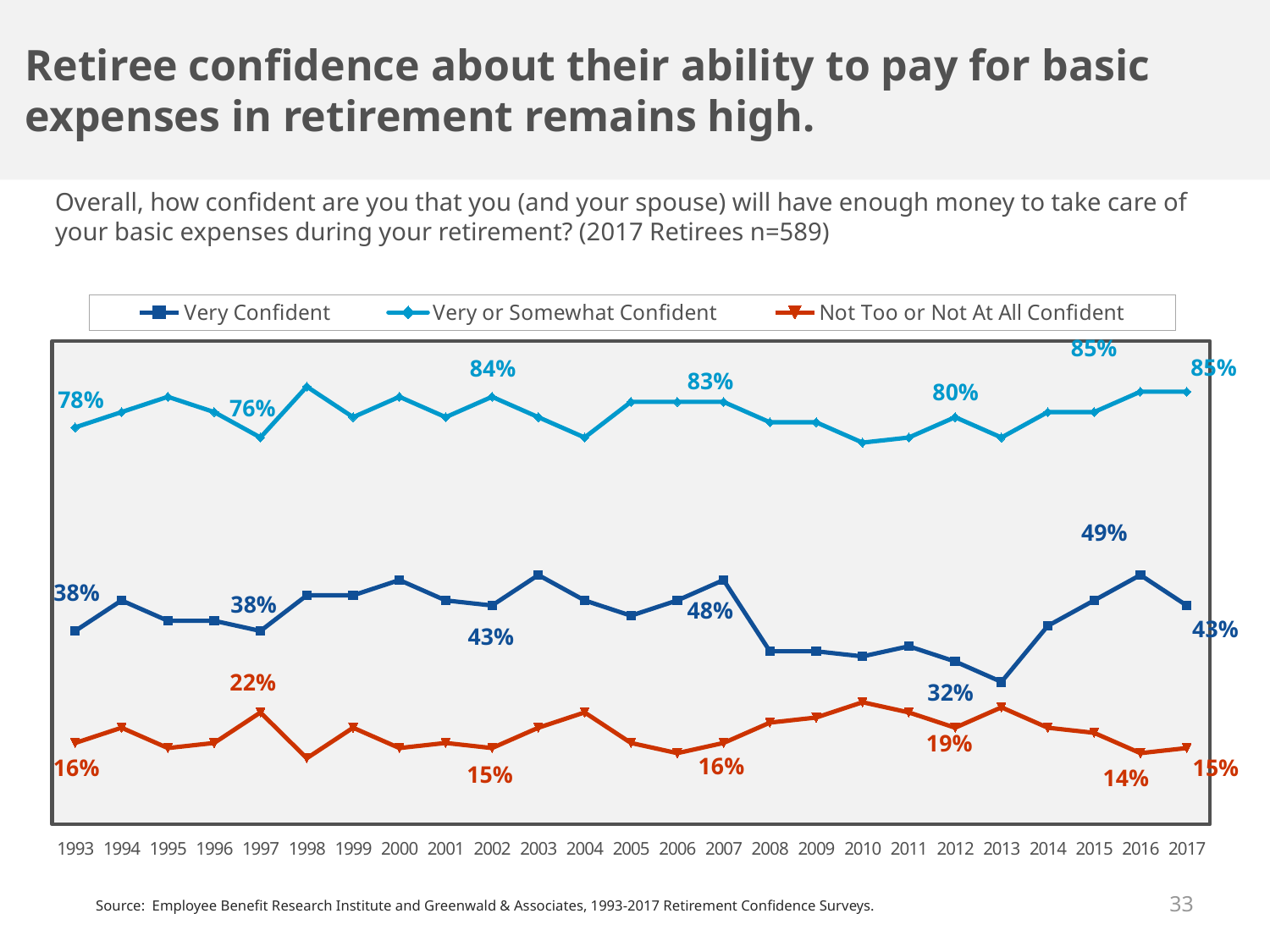
How many series does the legend list? 3 Which year has the higher Very Confident value, 2007 or 2012? 2007 By how many percentage points did Very or Somewhat Confident change from 1993 (78%) to 2017 (85%)? 7 percentage points What is the Very or Somewhat Confident value for 1993? 78% What is the Very Confident value for 2017? 43% Does the Very or Somewhat Confident line rise or fall between 2012 and 2017? Rise What kind of chart is shown on the slide? Line chart What is the Not Too or Not At All Confident value for 2012? 19% Which series is drawn with red triangle markers? Not Too or Not At All Confident How many years are shown along the x axis? 25 What is the difference between the Very Confident values for 2007 and 2012? 16 percentage points What is the Not Too or Not At All Confident value for 1997? 22%